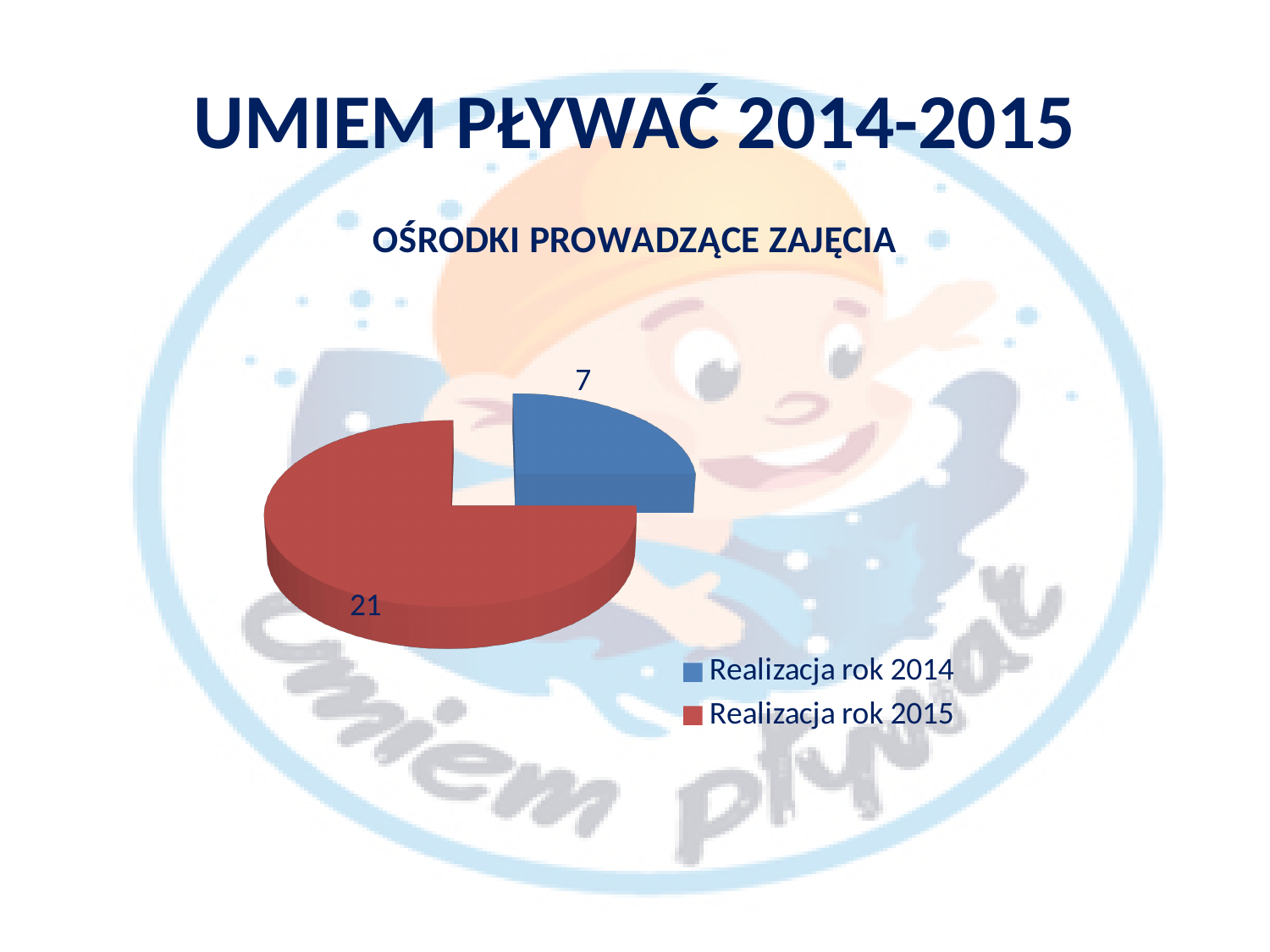
Which is larger, the value for Realizacja rok 2014 or Realizacja rok 2015? Realizacja rok 2015 What type of chart is shown on the slide? pie chart What is the total of all slices in the pie chart? 28 What is the value for Realizacja rok 2014? 7 What is the value for Realizacja rok 2015? 21 What is the title of the chart? OŚRODKI PROWADZĄCE ZAJĘCIA Which category has the smallest slice of the pie? Realizacja rok 2014 How many slices does the pie chart have? 2 What is the difference between the values for Realizacja rok 2015 and Realizacja rok 2014? 14 Which category has the largest slice of the pie? Realizacja rok 2015 How many entries does the legend list? 2 What share of the pie does Realizacja rok 2015 represent? 75%